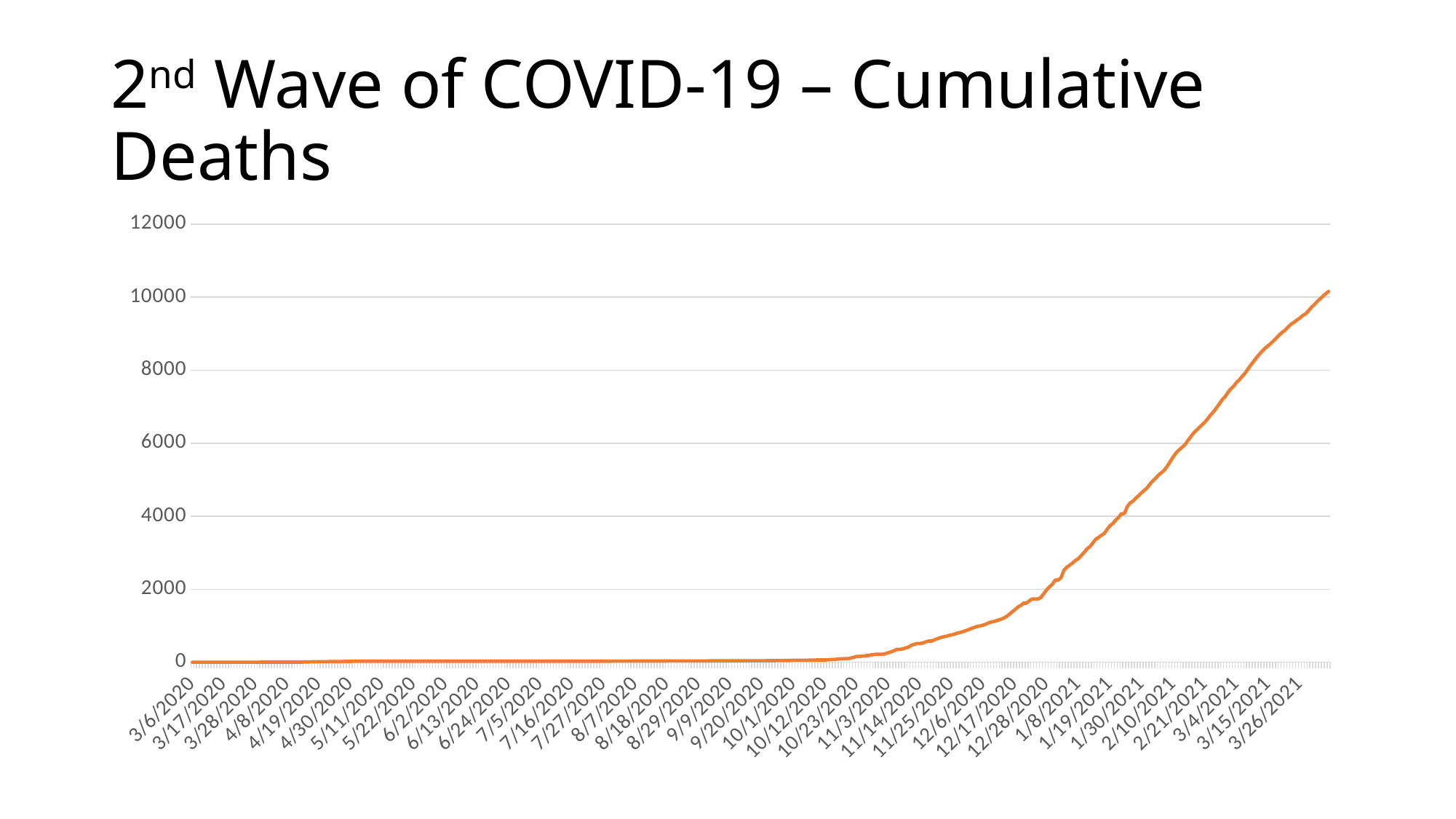
Is the value for 3/4/2021 greater or less than 6000? greater Is the value for 9/9/2020 greater or less than 2000? less Is the value for 12/6/2020 greater or less than 2000? less What is the title of the slide's chart? 2nd Wave of COVID-19 – Cumulative Deaths What colour is the line on the chart? orange What kind of chart is shown on the slide? line chart Which is larger, the value for 1/30/2021 or the value for 11/14/2020? 1/30/2021 Do the cumulative deaths rise or fall along the x axis from 3/6/2020 to 3/26/2021? rise